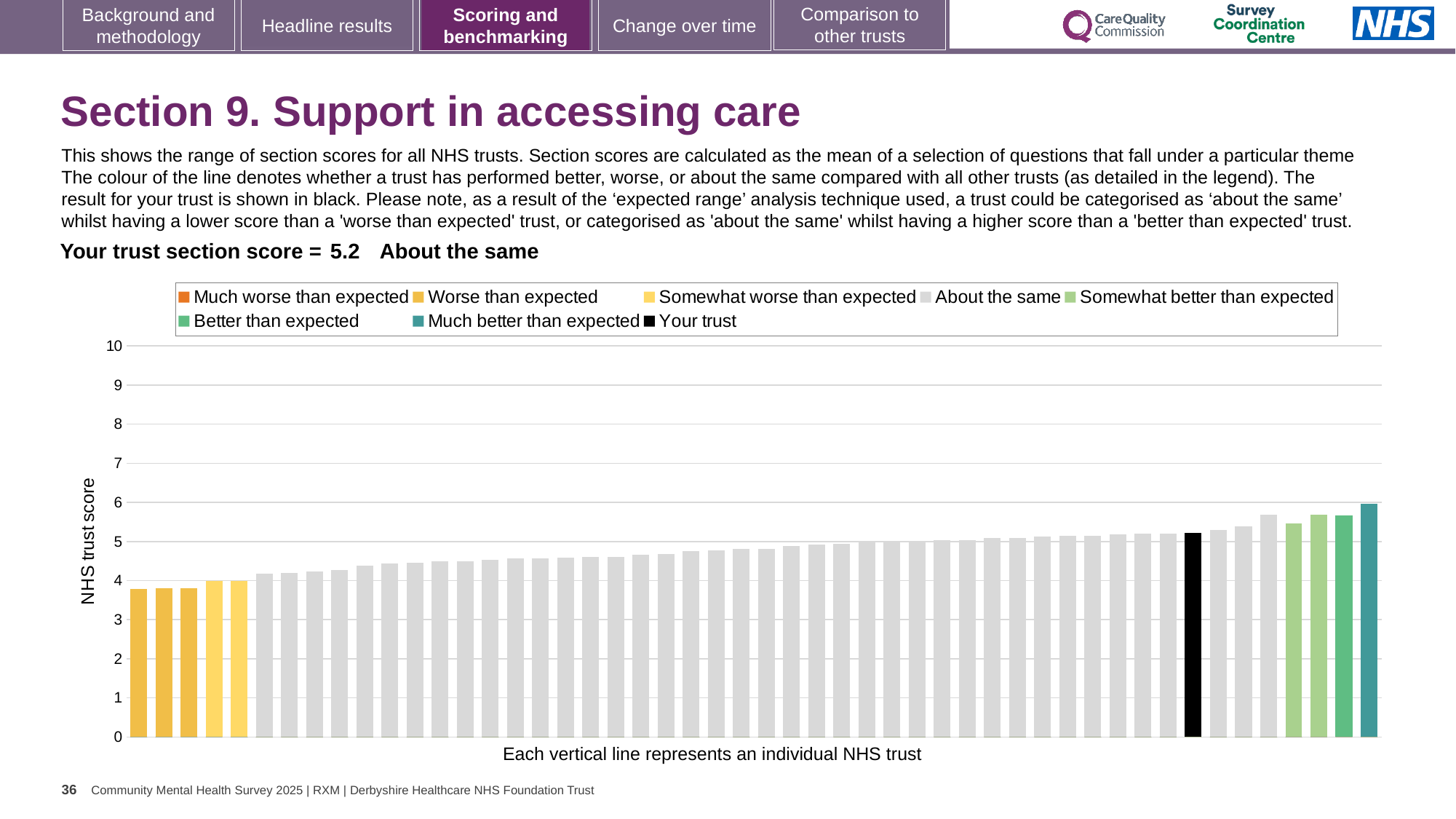
Which legend category does the tallest bar on the chart belong to? Much better than expected Do the bar values rise or fall from left to right across the chart? rise What is the section score for your trust shown on the slide? 5.2 Is the value of the black 'Your trust' bar greater or less than 5? greater What is the label on the vertical axis of the chart? NHS trust score What kind of chart is shown on the slide? bar chart Is the value of the leftmost bar greater or less than 4? less Is the value of the tallest bar greater or less than 5? greater Which category is your trust placed in for this section? About the same How many entries does the chart legend list? 8 What is the highest value shown on the vertical axis? 10 What colour is the bar representing your trust? black